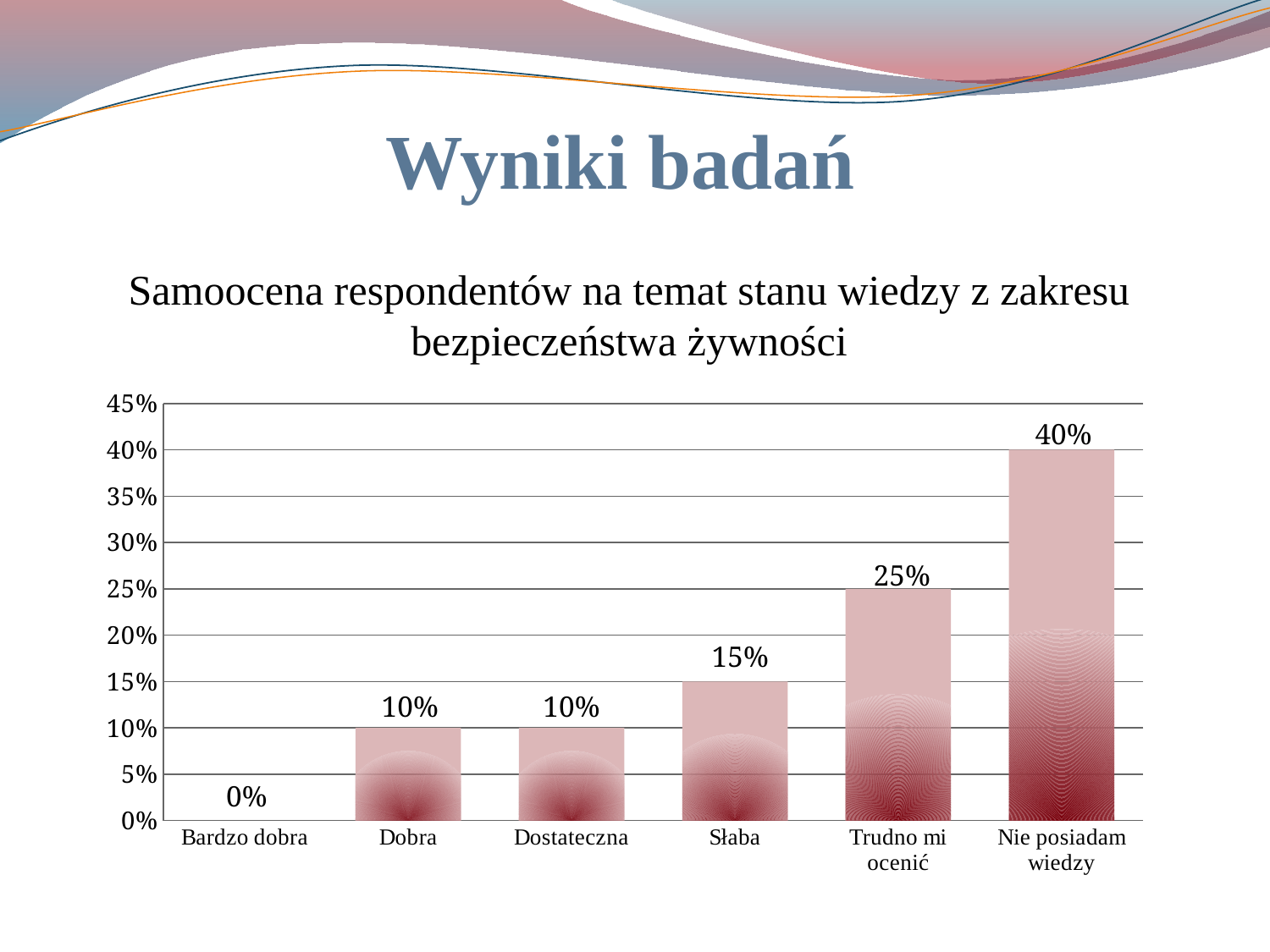
What is the value for "Słaba"? 15% Which category has the highest value? Nie posiadam wiedzy What is the value for "Bardzo dobra"? 0% What is the value for "Trudno mi ocenić"? 25% What is the difference between the values for "Słaba" and "Dobra"? 5% What kind of chart is shown on the slide? Bar chart What is the difference between the values for "Nie posiadam wiedzy" and "Trudno mi ocenić"? 15% Which category has the lowest value? Bardzo dobra How many categories are shown on the x axis? 6 Do the values generally rise or fall from left to right along the x axis? Rise Which is larger, the value for "Trudno mi ocenić" or the value for "Słaba"? Trudno mi ocenić What is the value for "Nie posiadam wiedzy"? 40%